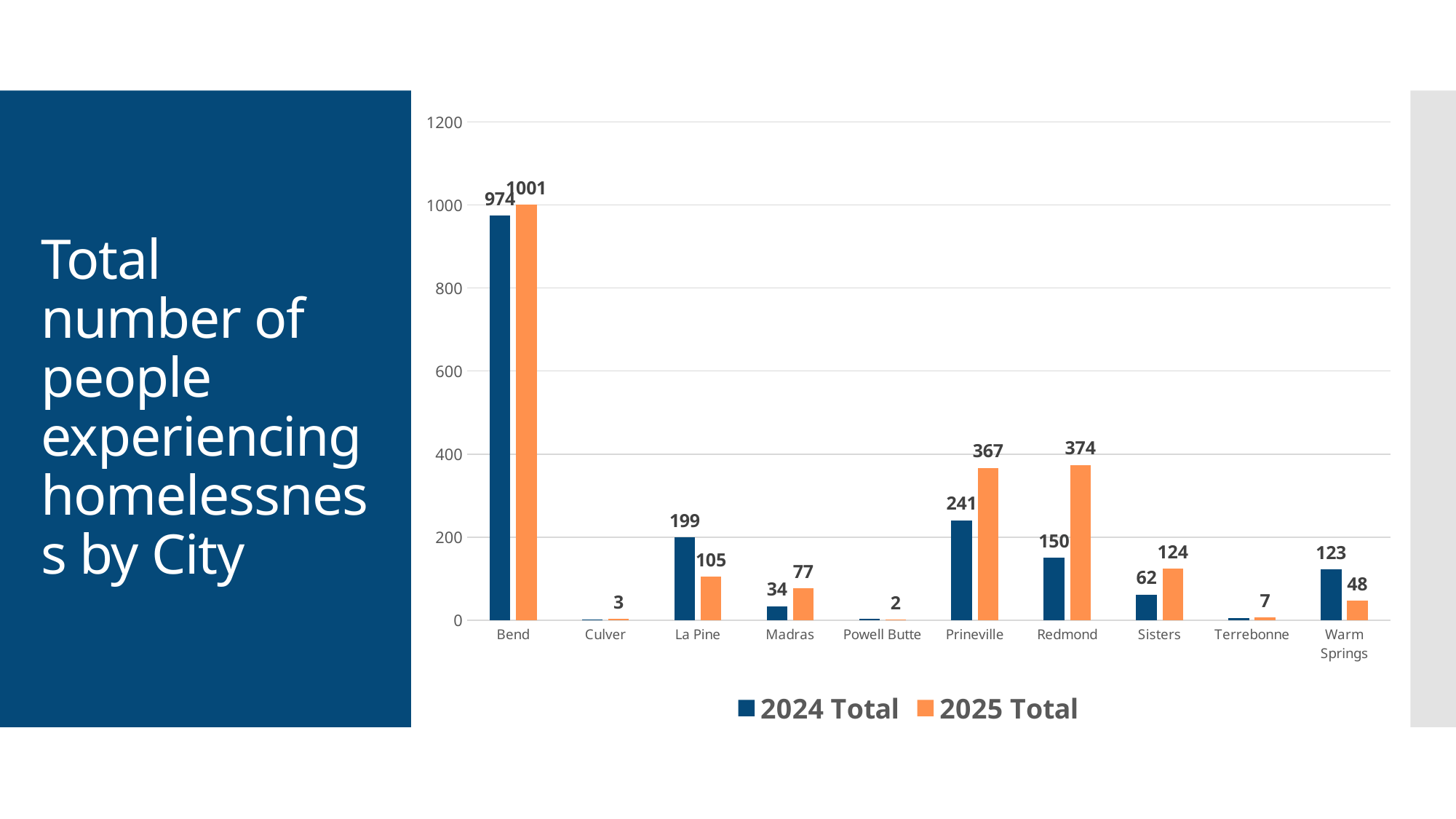
What colour represents the 2025 Total series? Orange How many series does the legend list? 2 Is the 2024 Total for Bend greater or less than 800? greater What is the 2025 Total for Madras? 77 What is the 2024 Total for La Pine? 199 What is the 2025 Total for Redmond? 374 Which city has the lowest labelled 2025 Total? Powell Butte What is the difference between the 2025 Total and the 2024 Total for Prineville? 126 How many cities are shown on the x axis? 10 What kind of chart is shown on the slide? Bar chart Which is larger for Warm Springs, the 2024 Total or the 2025 Total? 2024 Total Which city has the highest 2025 Total? Bend